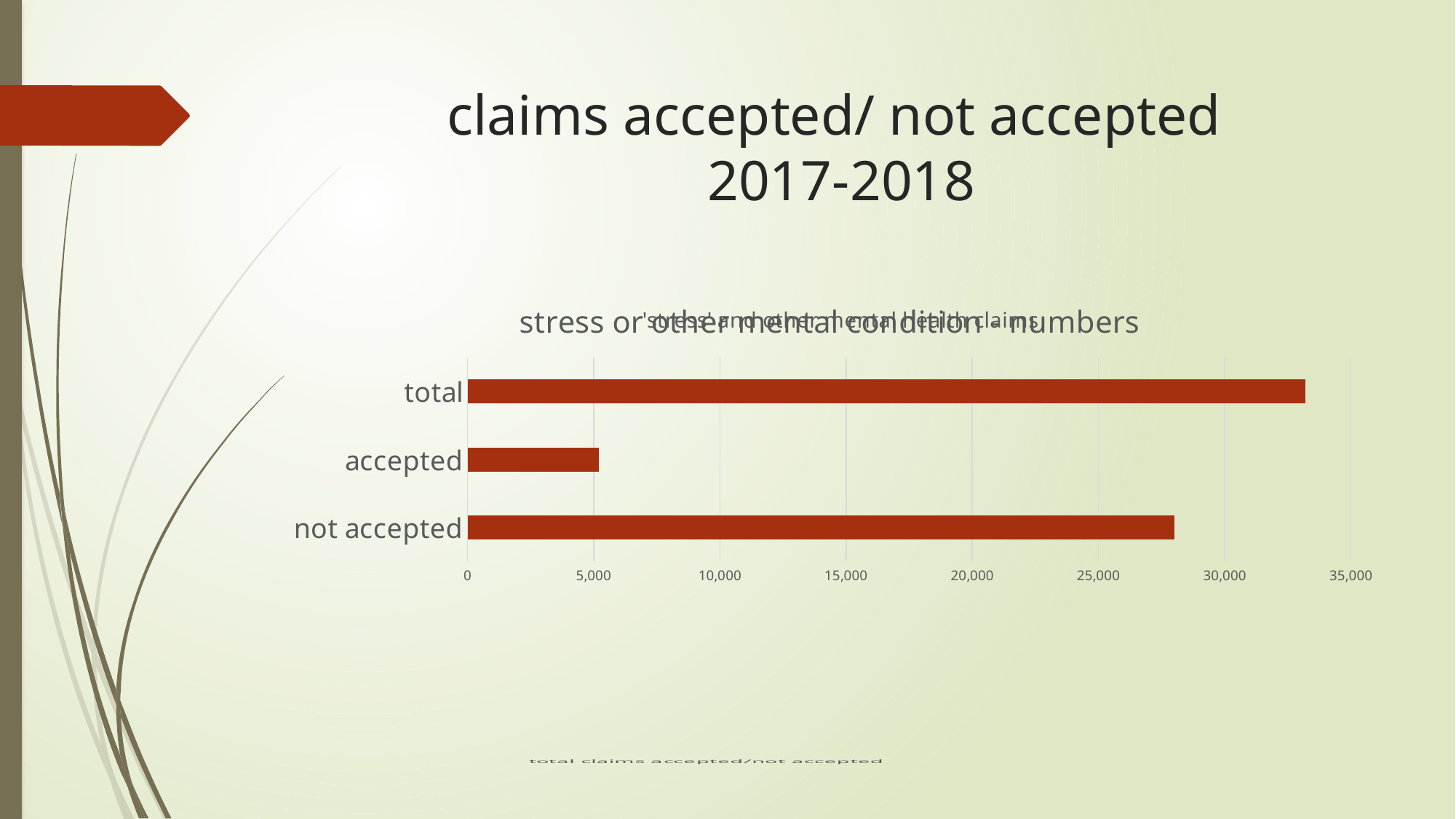
Which category has the highest value in the chart? total Is the value for not accepted greater or less than 25,000? greater Which category has the lowest value in the chart? accepted Is the value for not accepted greater or less than 30,000? less Is the value for total greater or less than 30,000? greater What kind of chart is shown on the slide? bar chart What is the highest value shown on the x axis of the chart? 35,000 Which is larger, the value for accepted or the value for not accepted? not accepted What is the title of the slide? claims accepted/ not accepted 2017-2018 How many categories are plotted in the chart? 3